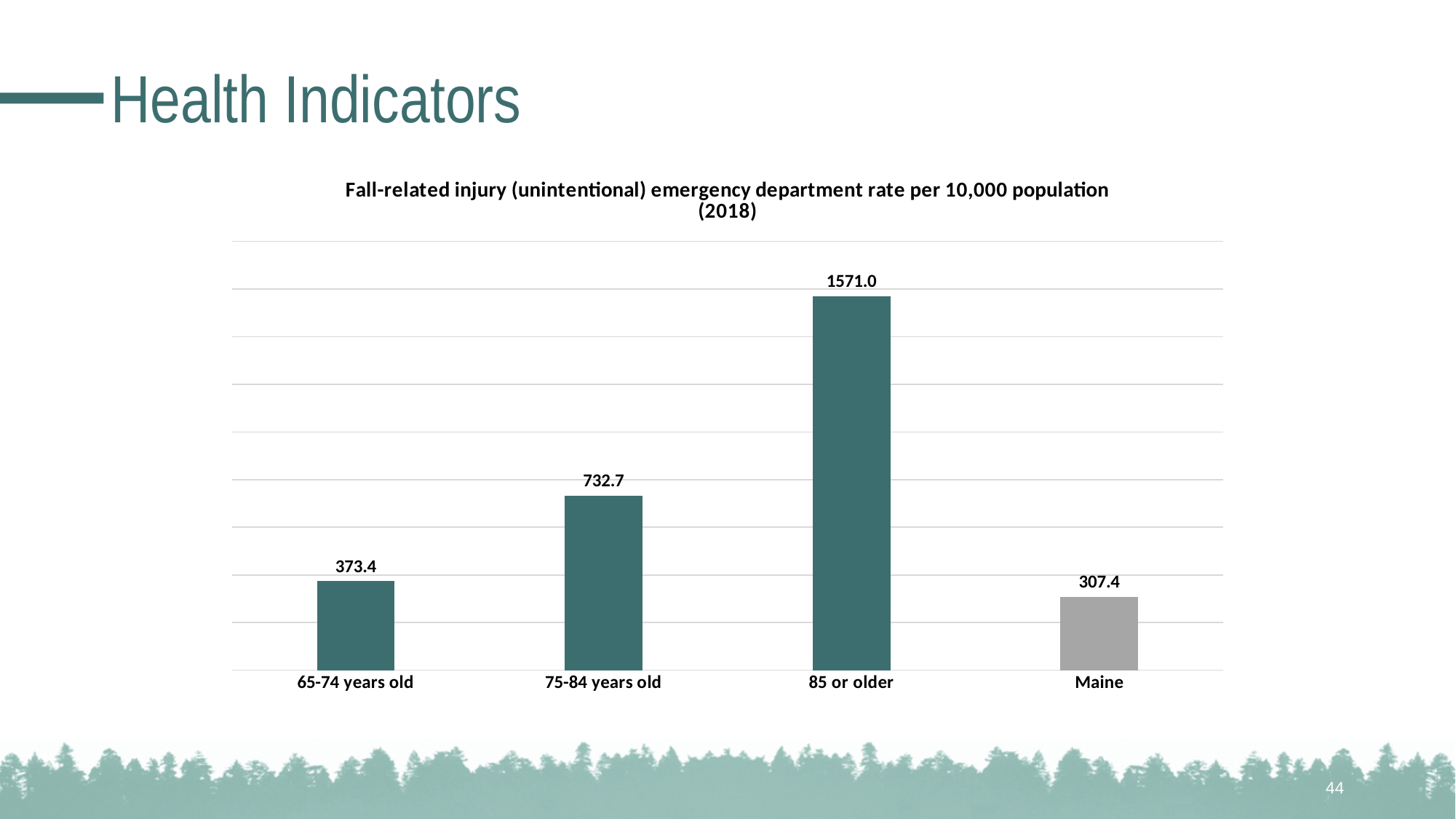
How many categories are shown in the chart? 4 Which category has the highest fall-related injury emergency department rate? 85 or older What is the fall-related injury emergency department rate for 65-74 years old? 373.4 What is the difference between the rate for 85 or older and the rate for 75-84 years old? 838.3 What is the difference between the rate for 65-74 years old and the rate for Maine? 66.0 Which is larger, the rate for 75-84 years old or the rate for 65-74 years old? 75-84 years old What year does the chart title say the data is from? 2018 What is the fall-related injury emergency department rate for 75-84 years old? 732.7 What kind of chart is shown on the slide? Bar chart What is the fall-related injury emergency department rate for 85 or older? 1571.0 Which category has the lowest fall-related injury emergency department rate? Maine What is the fall-related injury emergency department rate for Maine? 307.4